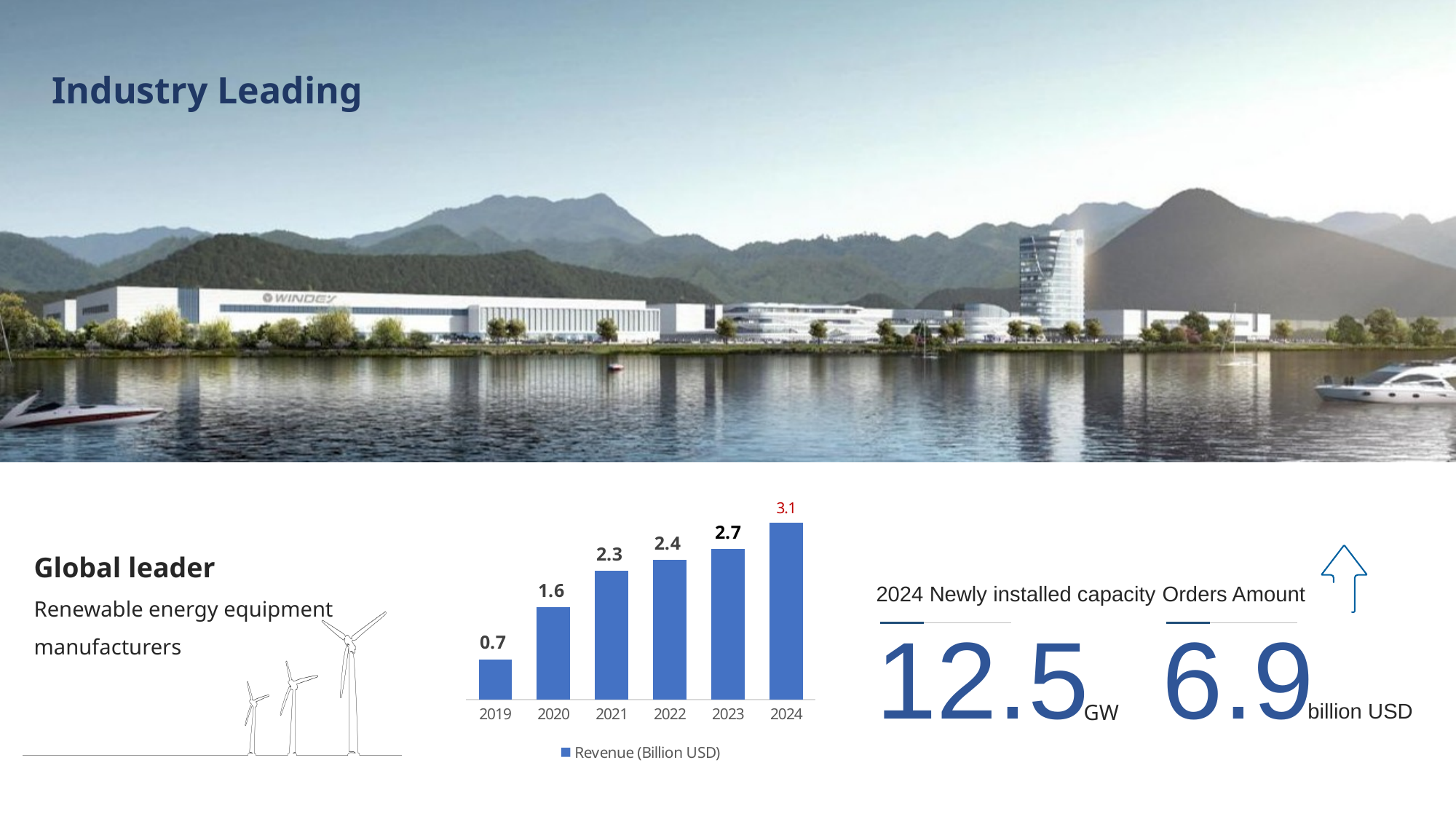
How many years are shown on the x axis of the chart? 6 How many series does the chart legend list? 1 Does revenue rise or fall from 2019 to 2024? Rise What is the revenue value shown for 2024? 3.1 What is the revenue value shown for 2019? 0.7 What is the revenue value shown for 2022? 2.4 What is the difference between the revenue for 2024 and the revenue for 2019? 2.4 What is the difference between the revenue for 2021 and the revenue for 2020? 0.7 Which year has the larger revenue, 2020 or 2023? 2023 Which year has the lowest revenue in the chart? 2019 Which year has the highest revenue in the chart? 2024 What kind of chart is used to show revenue? Bar chart